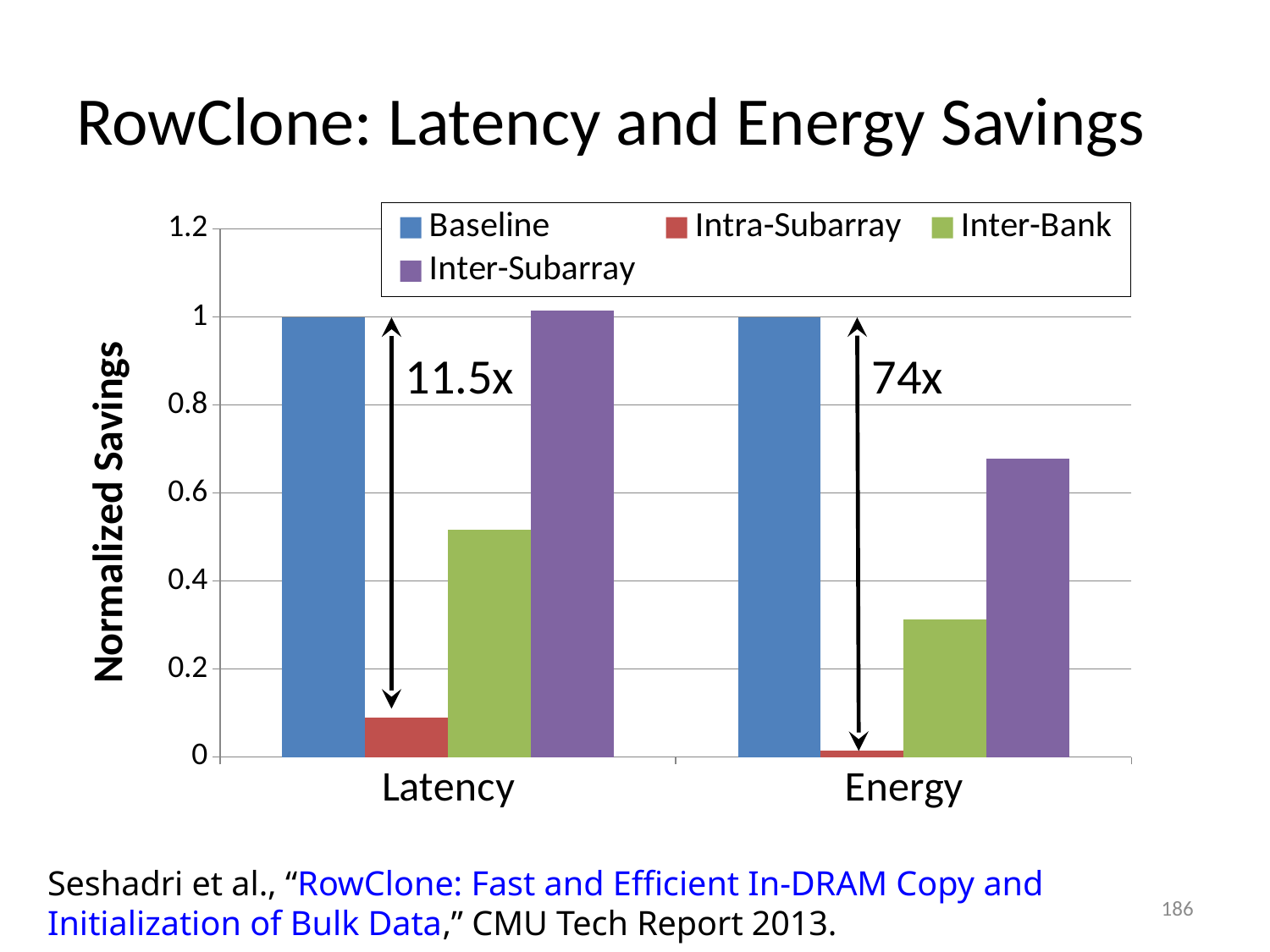
What kind of chart is shown on the slide? bar chart What is the Baseline value for Energy? 1 What is the Baseline value for Latency? 1 How many series does the chart's legend list? 4 What improvement factor is annotated above the Energy bars? 74x Is the Inter-Subarray value for Energy greater or less than 0.6? greater What is the title of the y axis? Normalized Savings Is the Inter-Bank value for Latency greater or less than 0.4? greater How many categories are shown on the x axis of the chart? 2 Is the Inter-Bank value for Energy greater or less than 0.4? less Which is larger: the Inter-Subarray value for Latency or the Inter-Subarray value for Energy? Latency Which series has the lowest value for Energy? Intra-Subarray